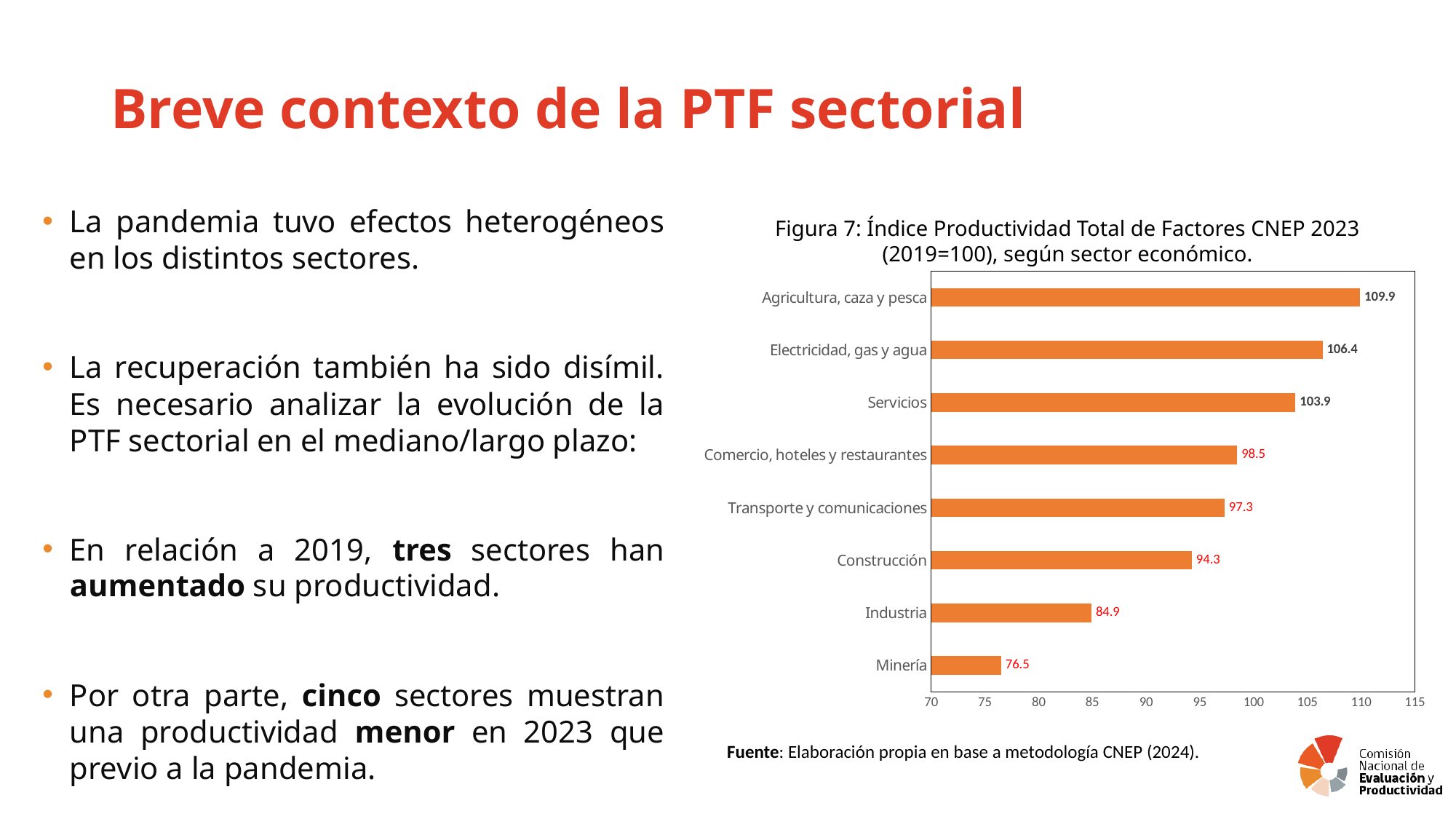
What is the value for Agricultura, caza y pesca? 109.9 What is the difference between the values for Agricultura, caza y pesca and Minería? 33.4 What is the title of the chart? Figura 7: Índice Productividad Total de Factores CNEP 2023 (2019=100), según sector económico. Which is larger, the value for Electricidad, gas y agua or the value for Servicios? Electricidad, gas y agua Which sector has the lowest value? Minería Is the value for Transporte y comunicaciones greater or less than 100? less How many sectors are shown in the chart? 8 What is the difference between the values for Servicios and Industria? 19.0 What is the value for Minería? 76.5 What kind of chart is shown on the slide? bar chart What is the value for Construcción? 94.3 Which sector has the highest value? Agricultura, caza y pesca